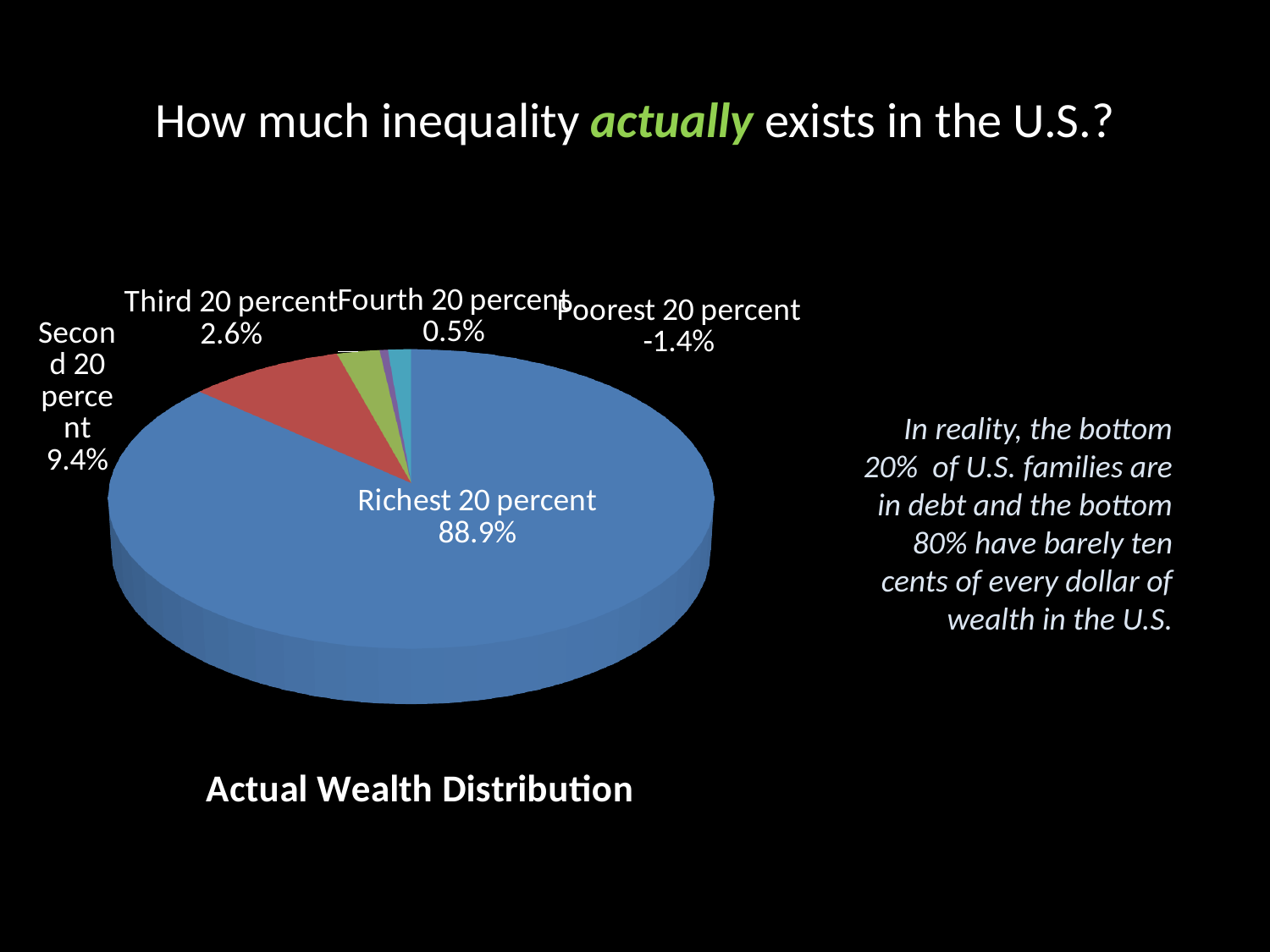
What is the value for the Second 20 percent? 9.4% What is the value for the Richest 20 percent? 88.9% Which category has the largest share of the pie? Richest 20 percent How many categories are shown in the pie chart? 5 Which is larger, the value for the Third 20 percent or the Fourth 20 percent? Third 20 percent What is the difference between the values for the Richest 20 percent and the Second 20 percent? 79.5% What is the value for the Fourth 20 percent? 0.5% What is the value for the Poorest 20 percent? -1.4% Which category has the lowest value? Poorest 20 percent What is the value for the Third 20 percent? 2.6% What is the title of the pie chart? Actual Wealth Distribution What kind of chart is shown on the slide? pie chart